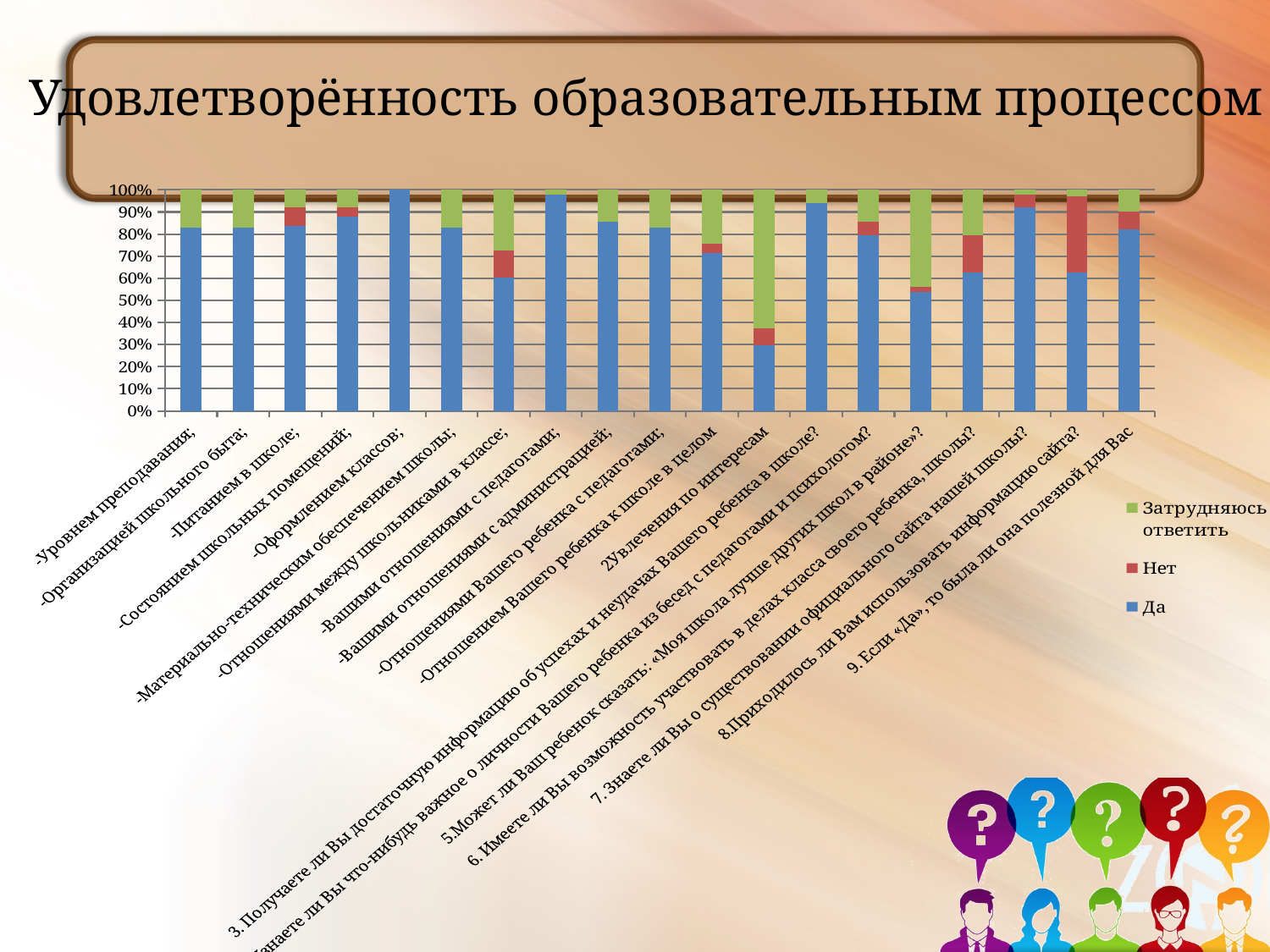
Which category has the highest share of «Да» responses? -Оформлением классов; Is the «Да» share for «-Оформлением классов;» greater or less than 90%? greater Is the «Да» share for «-Отношениями между школьниками в классе;» greater or less than 80%? less What is the title of the slide above the chart? Удовлетворённость образовательным процессом How many series does the legend list? 3 How many categories (bars) are plotted on the chart? 19 What is the total of each stacked bar on the chart? 100% Is the «Да» share for «2Увлечения по интересам» greater or less than 50%? less Which category has the lowest share of «Да» responses? 2Увлечения по интересам Which has a larger «Да» share: «-Оформлением классов;» or «2Увлечения по интересам»? -Оформлением классов; Which colour represents the series «Да» in the chart? Blue What type of chart is shown on the slide? Stacked bar chart